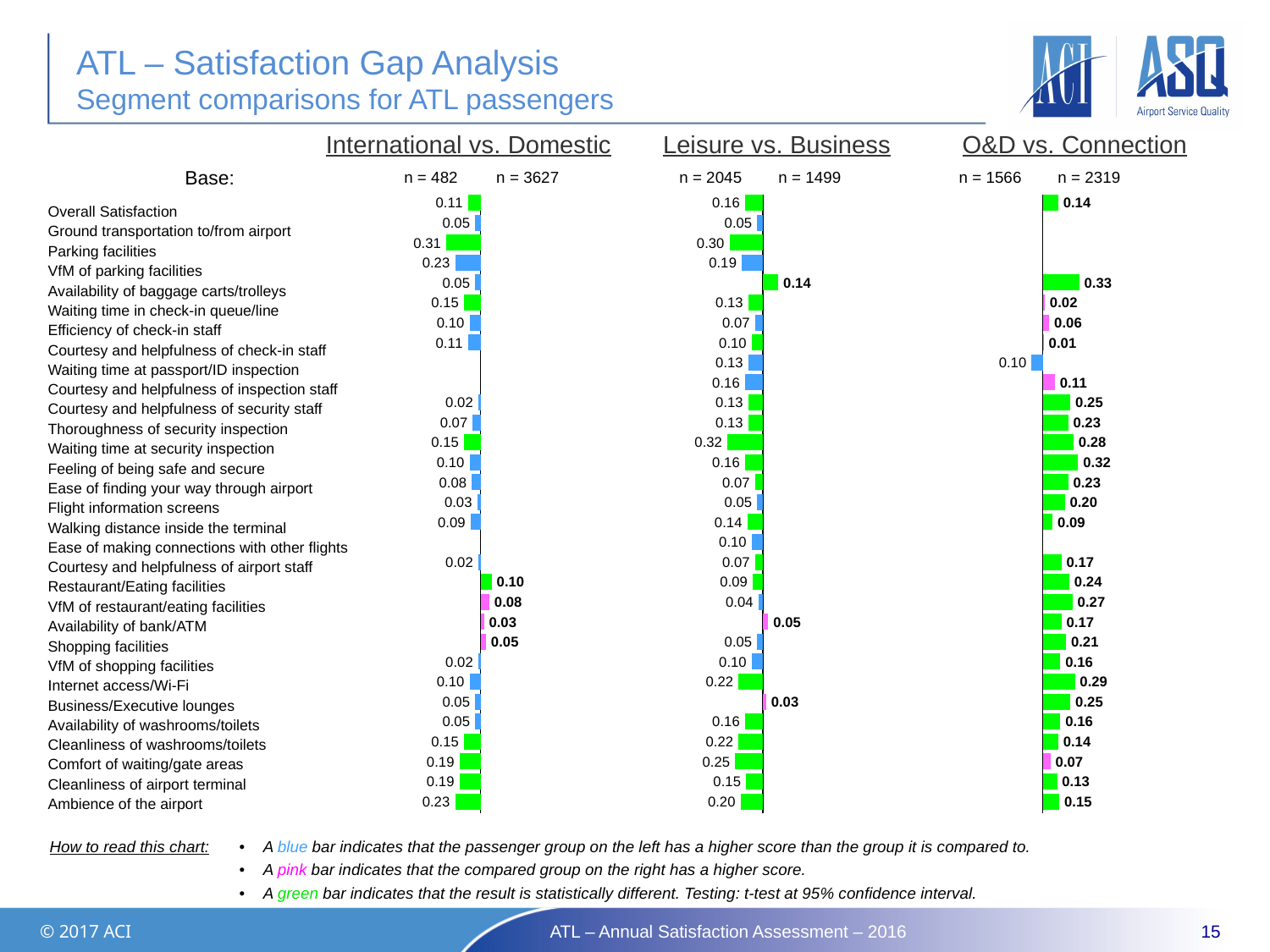
In the Leisure vs. Business chart, what is the value for Waiting time at security inspection? 0.32 In the O&D vs. Connection chart, what is the difference between the values for Internet access/Wi-Fi and Comfort of waiting/gate areas? 0.22 In the O&D vs. Connection chart, which is larger: the value for Feeling of being safe and secure or the value for Flight information screens? Feeling of being safe and secure In the O&D vs. Connection chart, what is the value for Availability of baggage carts/trolleys? 0.33 What type of chart is used on this slide? Bar chart What is the base (n) for the International group in the International vs. Domestic chart? n = 482 In the International vs. Domestic chart, what is the value for Restaurant/Eating facilities? 0.10 In the Leisure vs. Business chart, which item has the largest gap value? Waiting time at security inspection In the International vs. Domestic chart, which item has the largest gap value? Parking facilities In the Leisure vs. Business chart, what is the difference between the values for Parking facilities and Internet access/Wi-Fi? 0.08 In the International vs. Domestic chart, what is the value for Parking facilities? 0.31 In the O&D vs. Connection chart, which item has the smallest gap value? Courtesy and helpfulness of check-in staff